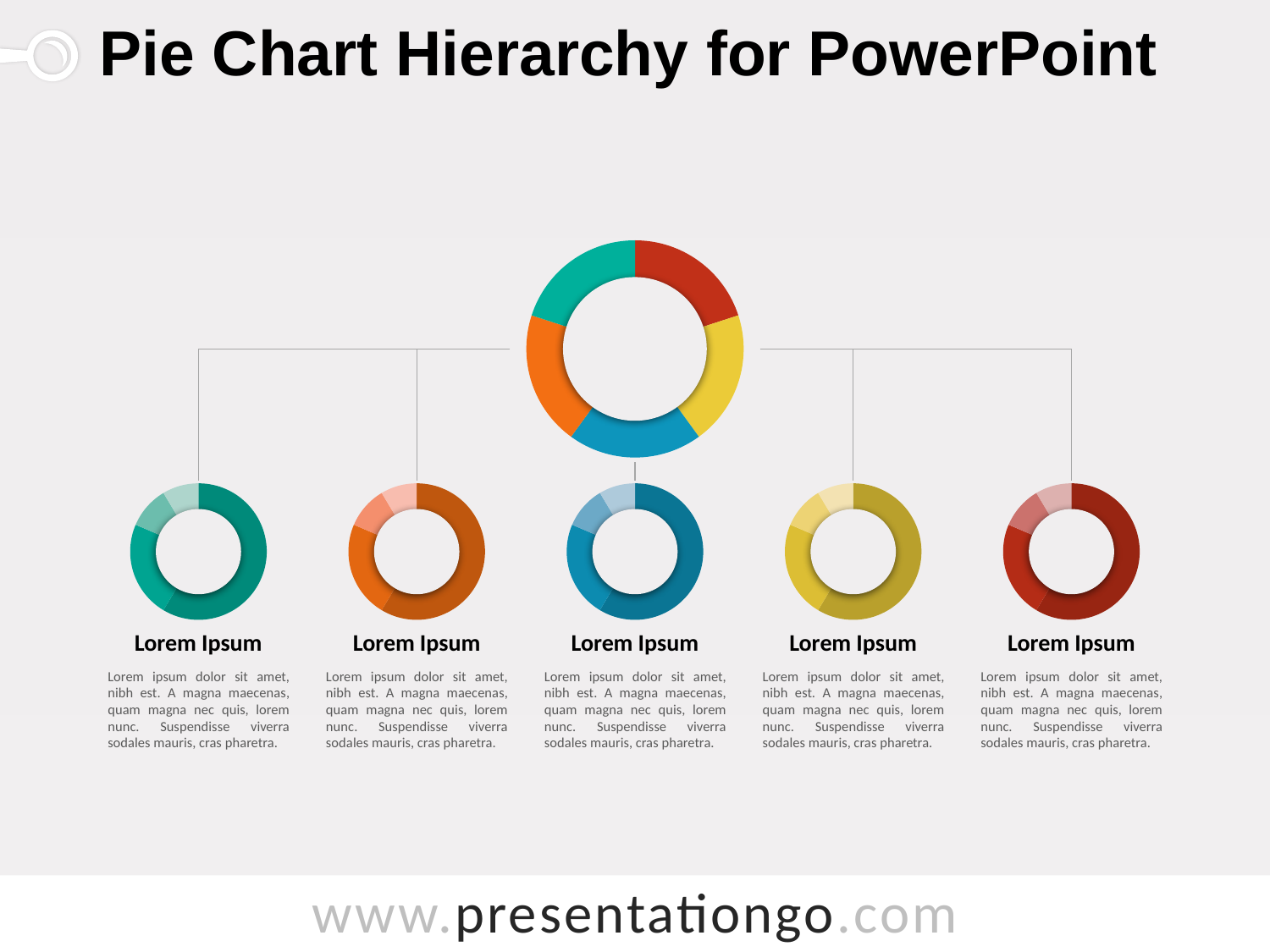
How many segments does the leftmost small pie chart (teal) have? 4 How many slices does the large central pie chart have? 5 What is the title of the slide containing the pie charts? Pie Chart Hierarchy for PowerPoint What kind of chart is the large chart at the top centre of the slide? Pie chart (donut) In the middle small pie chart (blue), is the dark blue segment larger or smaller than the two light segments combined? larger How many small pie charts are shown in the bottom row of the slide? 5 In the leftmost small pie chart, is the dark teal segment larger or smaller than the light teal segments combined? larger What colour is the slice at the top right of the large central pie chart? Red